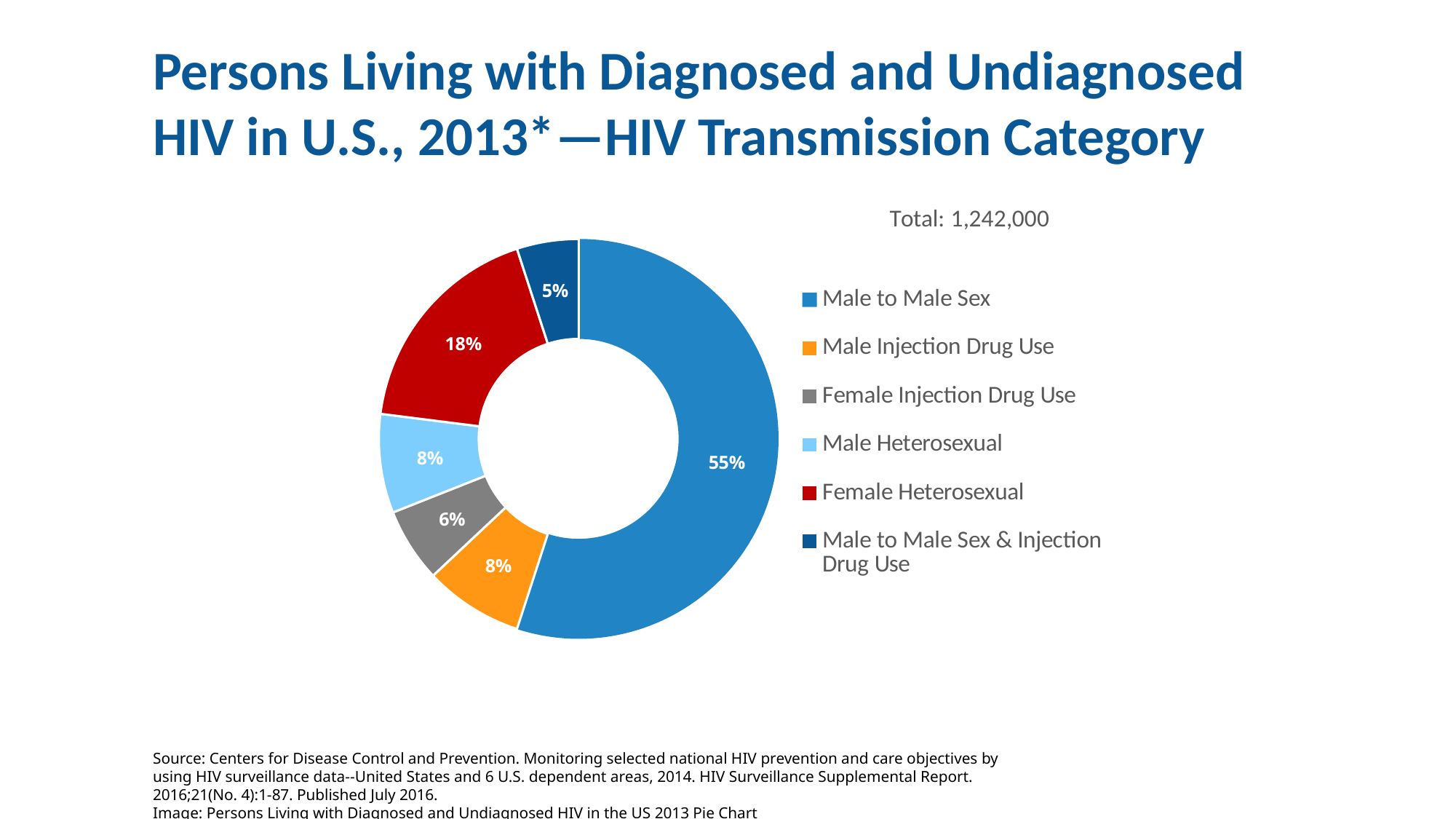
What colour is the Male Injection Drug Use slice? Orange What kind of chart is shown on the slide? Pie chart Which transmission category has the largest share? Male to Male Sex What percentage is shown for Female Heterosexual? 18% What percentage is shown for Male to Male Sex & Injection Drug Use? 5% How many transmission categories does the chart show? 6 What share of persons living with HIV is attributed to Male to Male Sex? 55% What total number of persons is shown on the slide? 1,242,000 What percentage is shown for Female Injection Drug Use? 6% Which transmission category has the smallest share? Male to Male Sex & Injection Drug Use Which is larger, the share for Female Heterosexual or the share for Male Heterosexual? Female Heterosexual What is the difference in percentage points between Male to Male Sex and Female Heterosexual? 37 percentage points